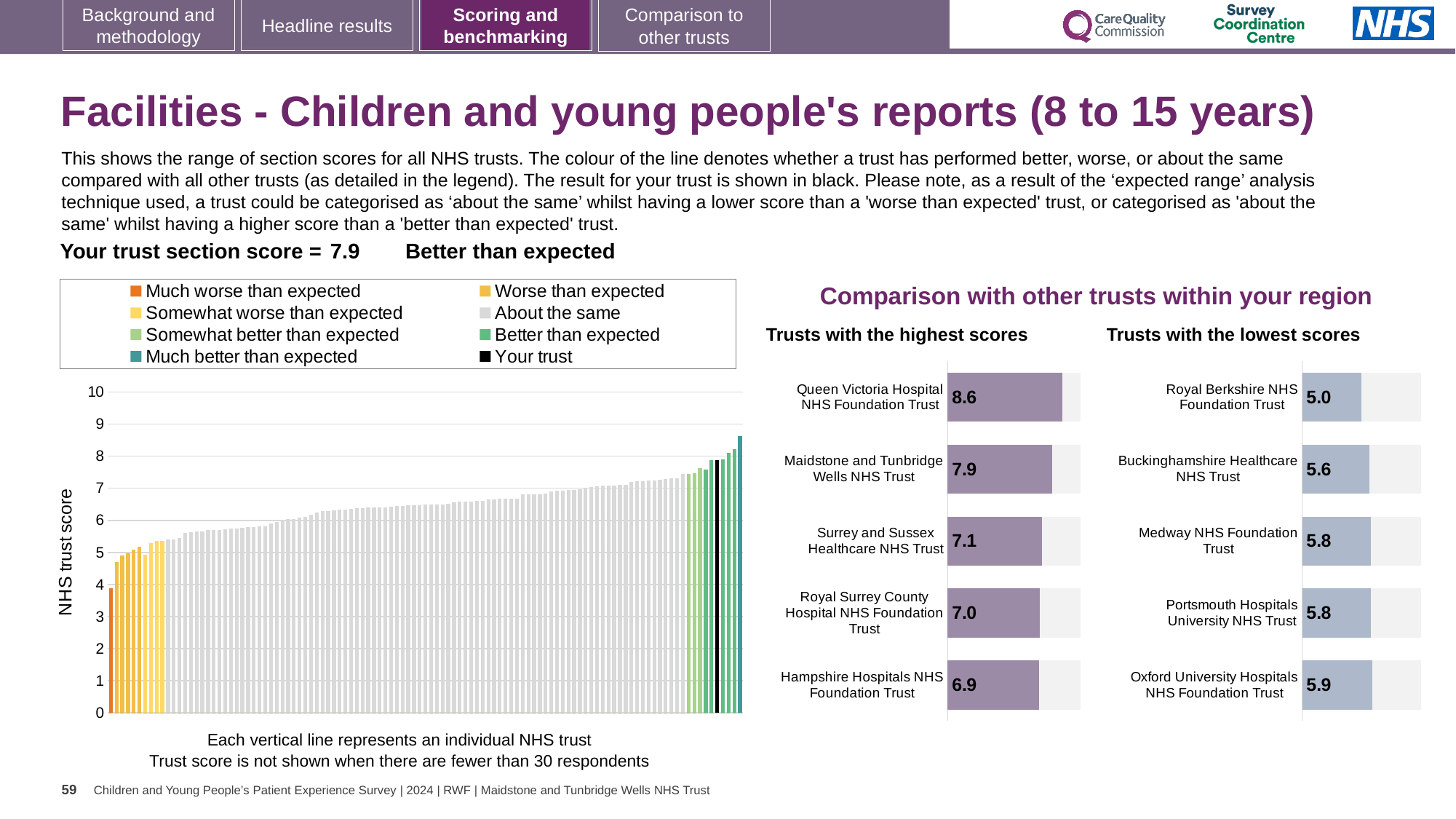
In the 'Trusts with the lowest scores' chart, what is the score for Royal Berkshire NHS Foundation Trust? 5.0 In the 'Trusts with the lowest scores' chart, which has the larger score: Buckinghamshire Healthcare NHS Trust or Medway NHS Foundation Trust? Medway NHS Foundation Trust In the 'Trusts with the lowest scores' chart, which trust has the highest score? Oxford University Hospitals NHS Foundation Trust In the 'Trusts with the highest scores' chart, what is the score for Maidstone and Tunbridge Wells NHS Trust? 7.9 In the 'Trusts with the highest scores' chart, what is the score for Queen Victoria Hospital NHS Foundation Trust? 8.6 In the 'Trusts with the highest scores' chart, what is the difference between the scores of Queen Victoria Hospital NHS Foundation Trust and Surrey and Sussex Healthcare NHS Trust? 1.5 How many entries does the legend of the NHS trust score chart on the left list? 8 In the 'Trusts with the highest scores' chart, which trust has the lowest score? Hampshire Hospitals NHS Foundation Trust How many trusts are shown in the 'Trusts with the highest scores' chart? 5 In the 'Trusts with the lowest scores' chart, what is the difference between the scores of Oxford University Hospitals NHS Foundation Trust and Royal Berkshire NHS Foundation Trust? 0.9 In the NHS trust score chart on the left, is the value for the black 'Your trust' bar greater or less than 7? greater In the NHS trust score chart on the left, do the trust scores rise or fall from left to right? rise